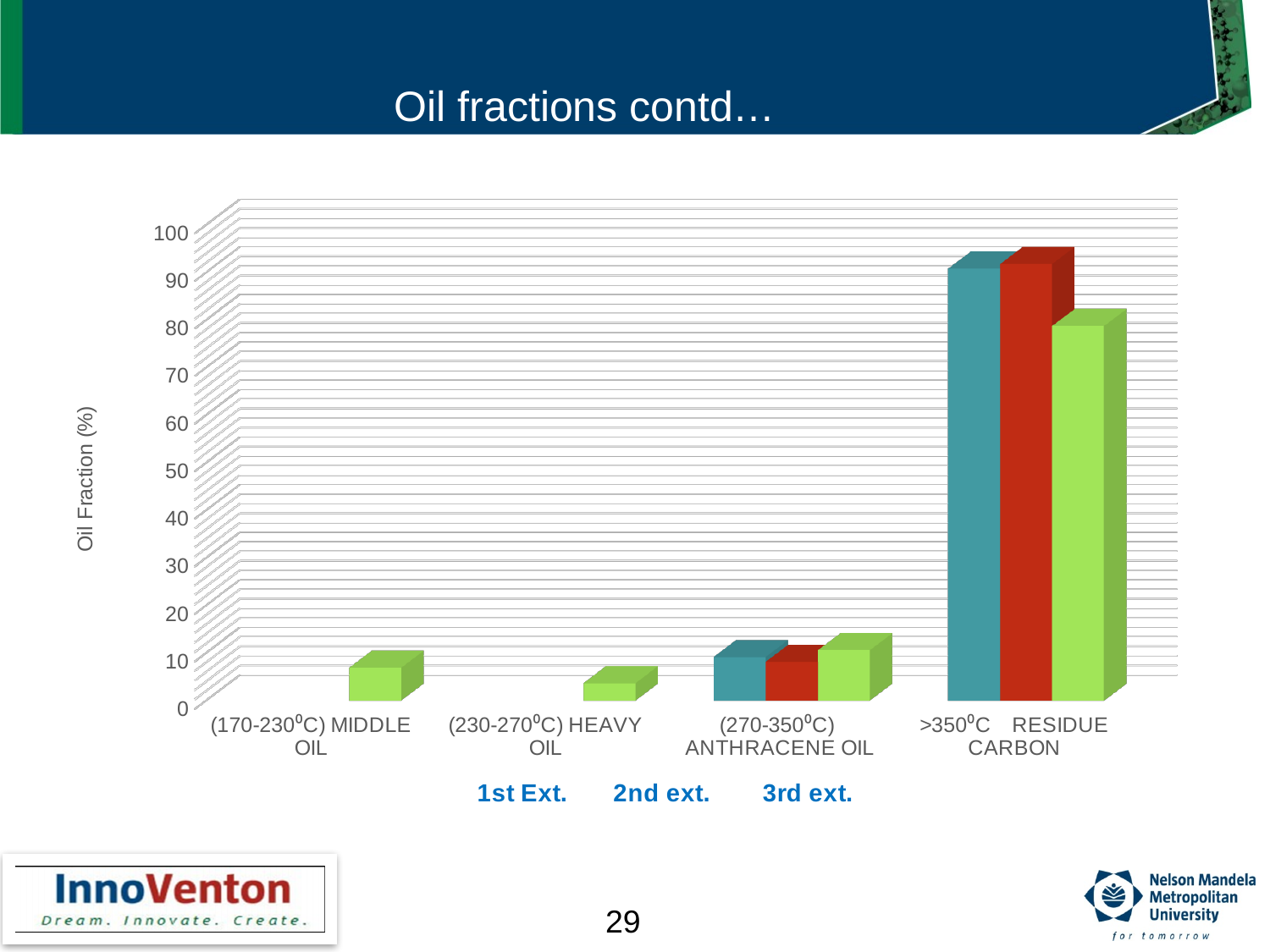
How many oil fraction categories are shown on the x axis? 4 Is the 1st Ext. value for >350⁰C RESIDUE CARBON greater or less than 80? greater Is the 3rd ext. value for >350⁰C RESIDUE CARBON greater or less than 90? less Which category has the highest oil fraction values? >350⁰C RESIDUE CARBON Is the 3rd ext. value for (170-230⁰C) MIDDLE OIL greater or less than 20? less Which is larger: the 3rd ext. value for (270-350⁰C) ANTHRACENE OIL or the 3rd ext. value for (230-270⁰C) HEAVY OIL? (270-350⁰C) ANTHRACENE OIL What is the label on the vertical axis? Oil Fraction (%) For >350⁰C RESIDUE CARBON, which is larger: the 1st Ext. value or the 3rd ext. value? 1st Ext. What kind of chart is shown on the slide? Bar chart What are the three series listed in the legend? 1st Ext., 2nd ext., 3rd ext. How many series does the legend list? 3